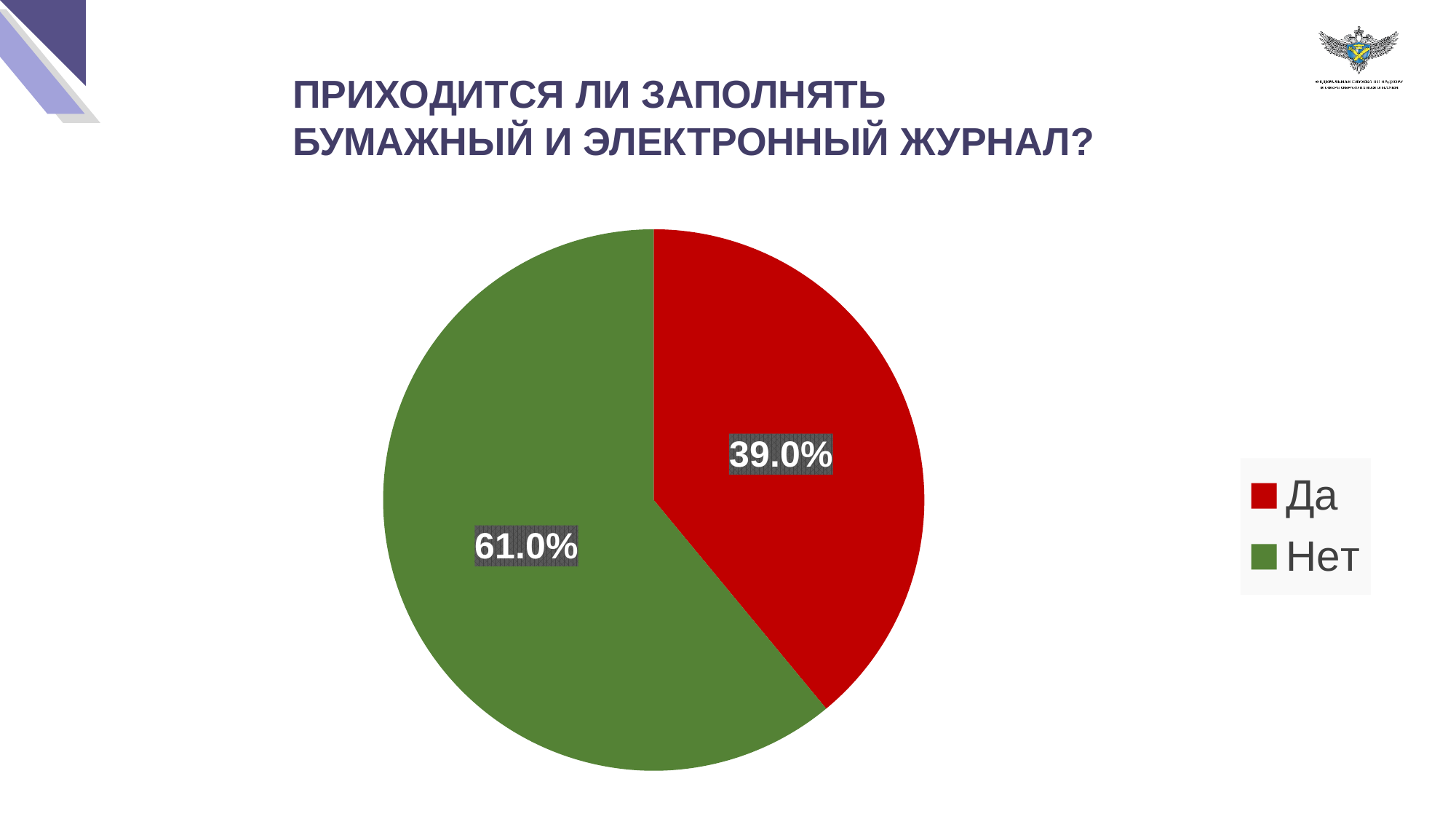
What colour is the "Да" slice? red What is the value for "Нет"? 61.0% Which is larger, the share for "Да" or the share for "Нет"? Нет What share of the pie does the "Да" slice represent? 39.0% What is the value for "Да"? 39.0% What kind of chart is shown on the slide? pie chart What is the difference between the shares for "Нет" and "Да"? 22.0% Which category has the largest share of the pie? Нет What colour is the "Нет" slice? green How many entries does the legend list? 2 Which category has the smallest share of the pie? Да How many slices does the pie chart have? 2